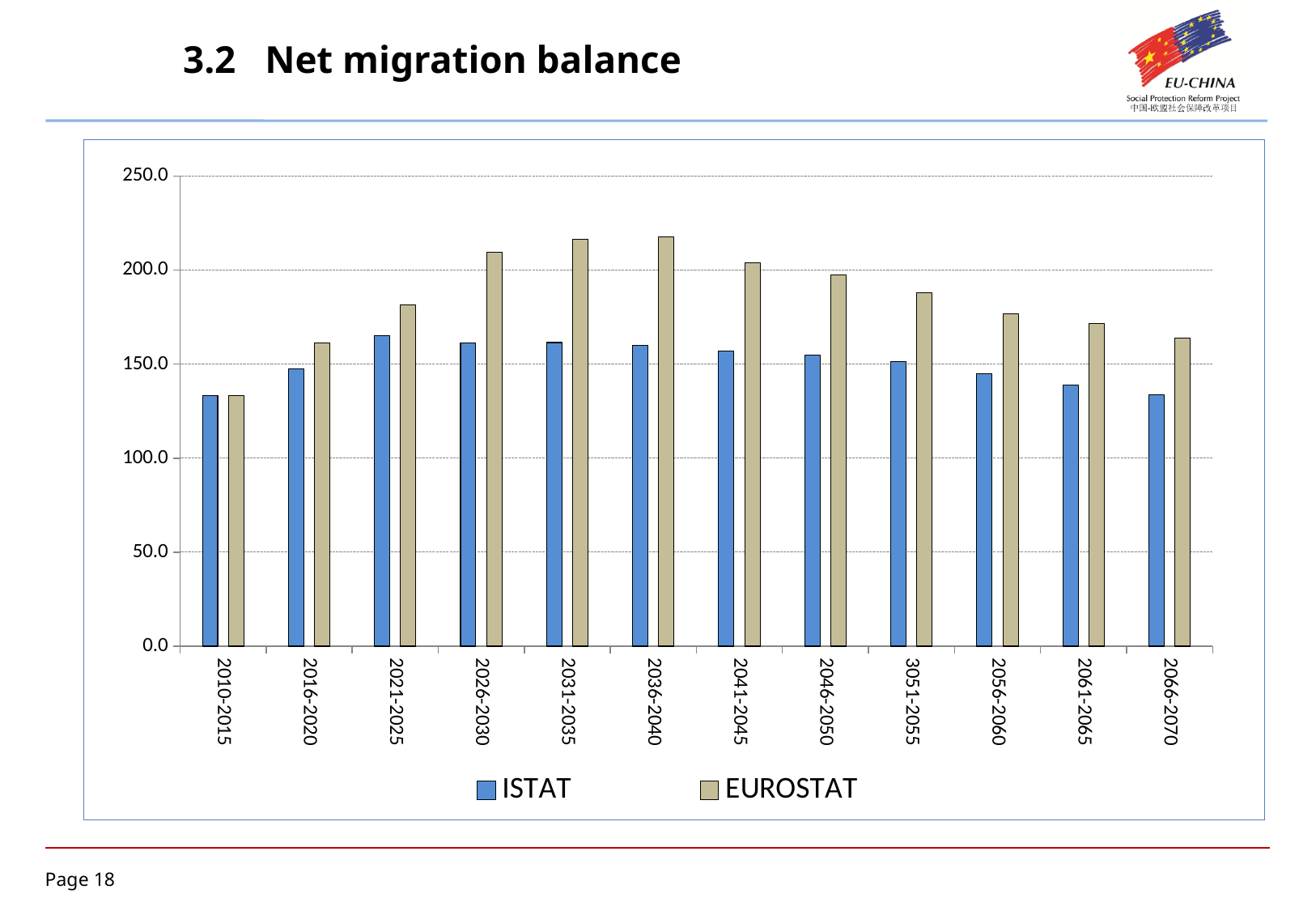
Which period has the lowest EUROSTAT value? 2010-2015 How many series does the legend list? 2 Is the ISTAT value for 2061-2065 greater or less than 150.0? less What kind of chart is shown on the slide? bar chart Is the EUROSTAT value for 2026-2030 greater or less than 200.0? greater Do the EUROSTAT values rise or fall from 2036-2040 to 2066-2070? fall What are the two series named in the legend? ISTAT and EUROSTAT Is the EUROSTAT value for 2066-2070 greater or less than 150.0? greater For 2041-2045, which series has the larger value, ISTAT or EUROSTAT? EUROSTAT How many period categories are shown on the x axis? 12